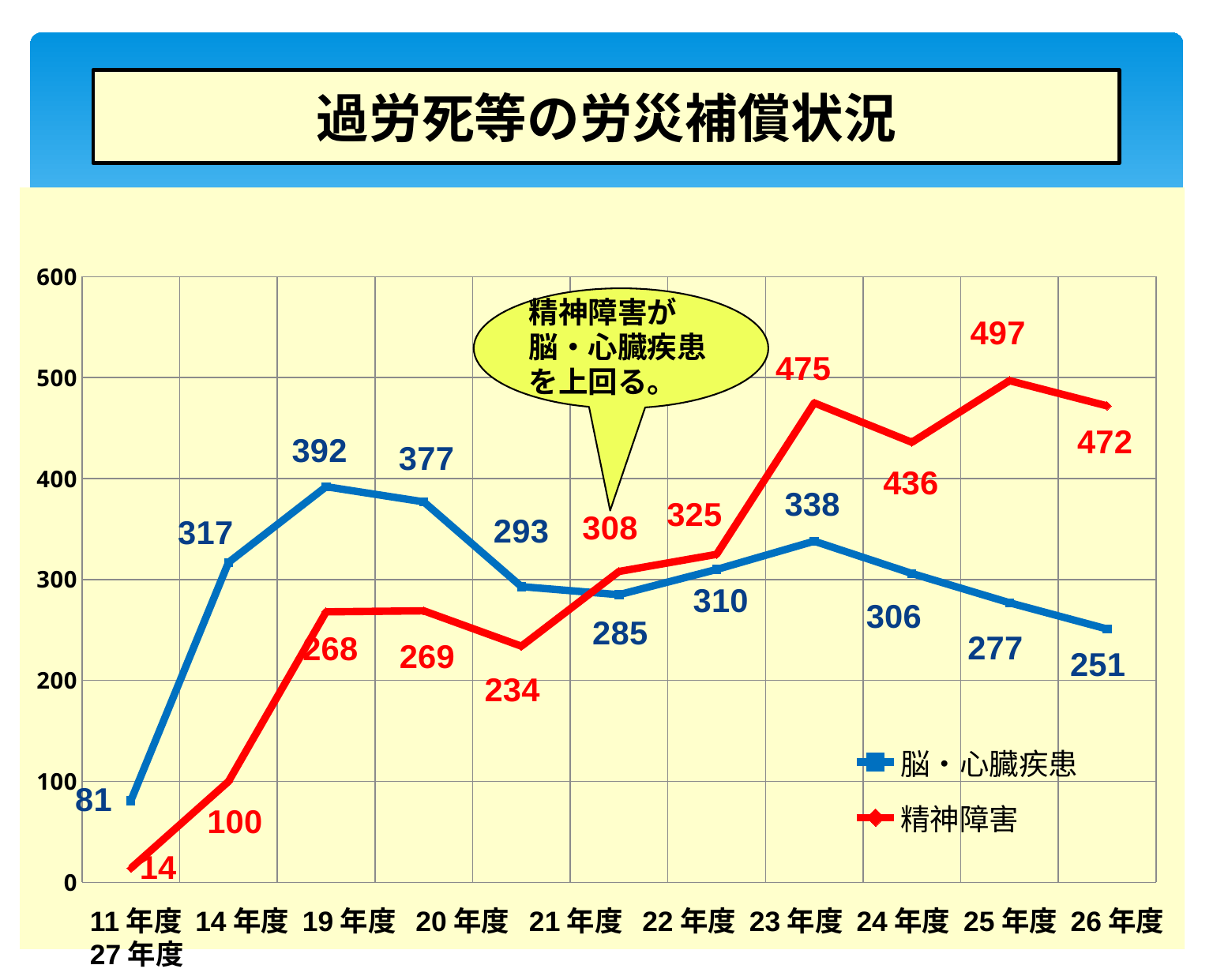
What is the lowest value plotted for 精神障害? 14 What is the highest value plotted for 精神障害? 497 What is the value of the last plotted point for 精神障害? 472 What is the lowest value plotted for 脳・心臓疾患? 81 How many series does the legend list? 2 What is the title of the chart? 過労死等の労災補償状況 What kind of chart is shown on the slide? line chart What is the difference between the last plotted values of 精神障害 (472) and 脳・心臓疾患 (251)? 221 At the first plotted point, which series has the larger value, 脳・心臓疾患 or 精神障害? 脳・心臓疾患 Which series is drawn in red? 精神障害 What is the highest value plotted for 脳・心臓疾患? 392 What is the value of the last plotted point for 脳・心臓疾患? 251